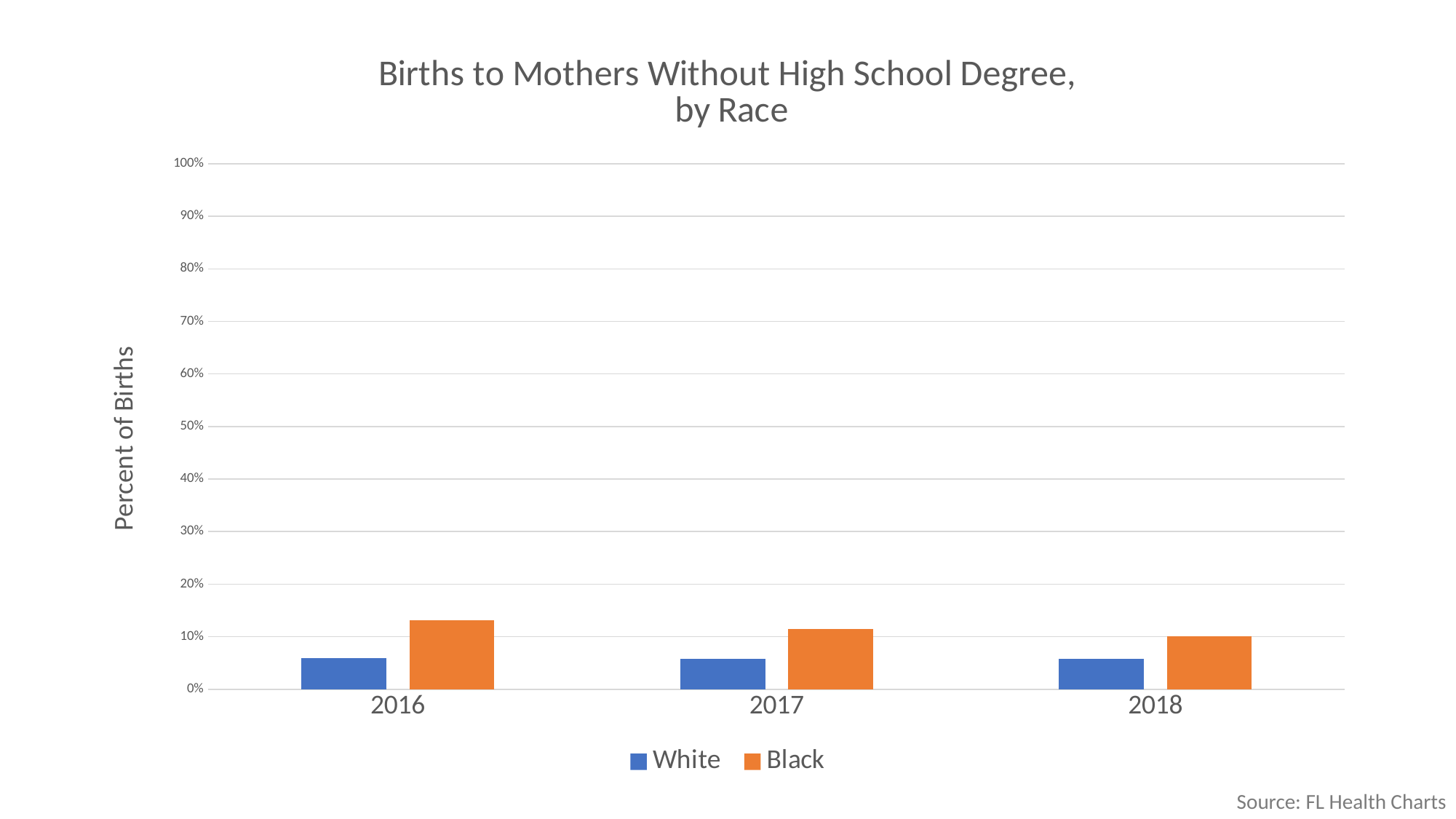
How many years are shown on the x axis? 3 Do the values for Black rise or fall from 2016 to 2018? fall What kind of chart is shown on the slide? bar chart In which year is the value for Black the highest? 2016 What is the y-axis label of the chart? Percent of Births Is the value for Black in 2017 greater or less than 10%? greater Is the value for White in 2016 greater or less than 10%? less Which series is shown in orange? Black In 2017, which series has the larger value, White or Black? Black Is the value for Black in 2016 greater or less than 10%? greater How many series does the legend list? 2